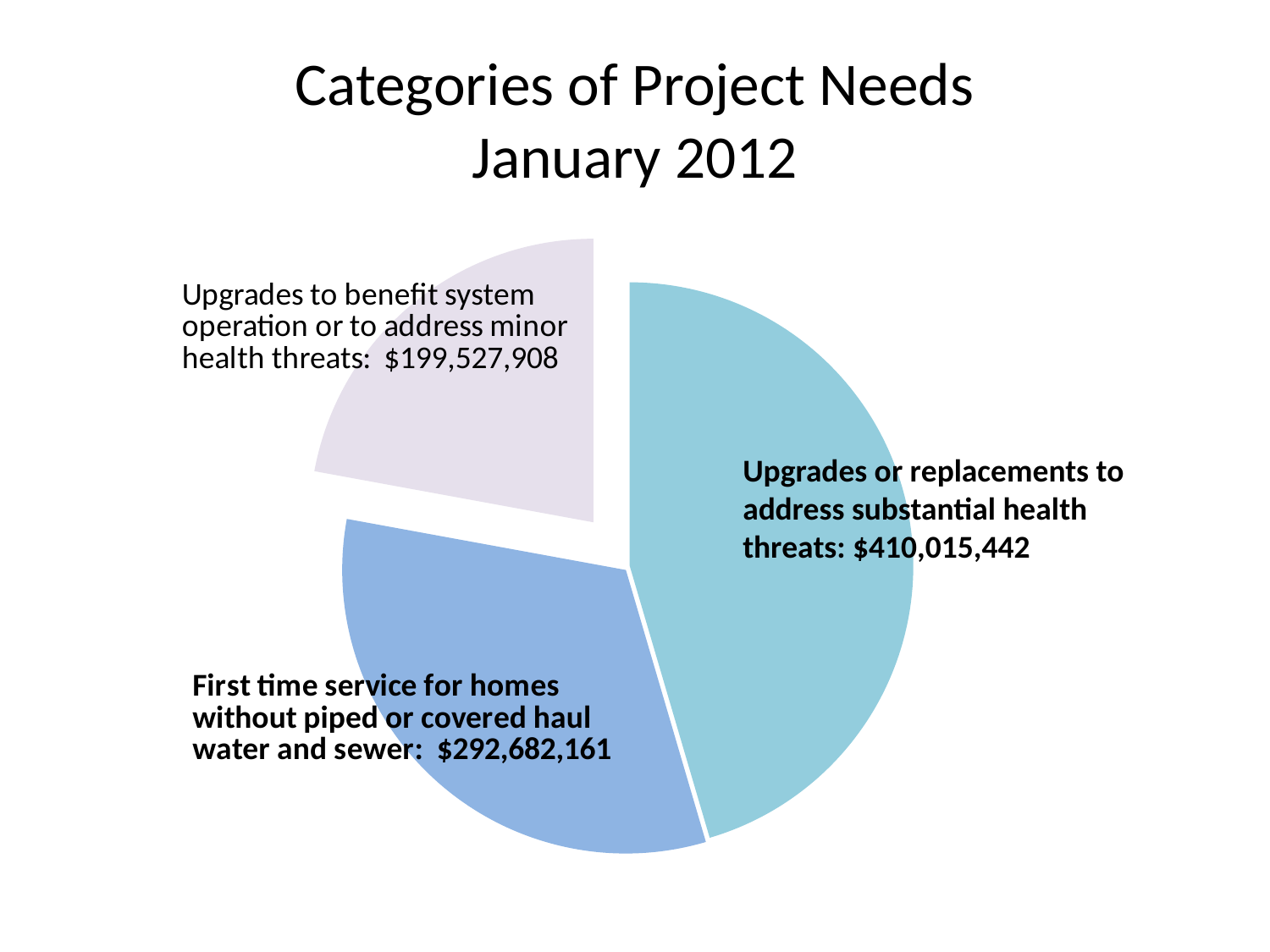
How many categories are shown in the pie chart? 3 What is the difference between the value for substantial health threats and the value for minor health threats? $210,487,534 Which category has the smallest value? Upgrades to benefit system operation or to address minor health threats Which category has the largest value? Upgrades or replacements to address substantial health threats What is the title of the chart on the slide? Categories of Project Needs January 2012 Which is larger: the value for first time service or the value for minor health threats? First time service What kind of chart is shown on the slide? Pie chart What is the value for 'Upgrades to benefit system operation or to address minor health threats'? $199,527,908 What is the value for 'First time service for homes without piped or covered haul water and sewer'? $292,682,161 What is the value for 'Upgrades or replacements to address substantial health threats'? $410,015,442 What is the difference between the value for substantial health threats and the value for first time service? $117,333,281 What is the total of all three categories in the pie chart? $902,225,511